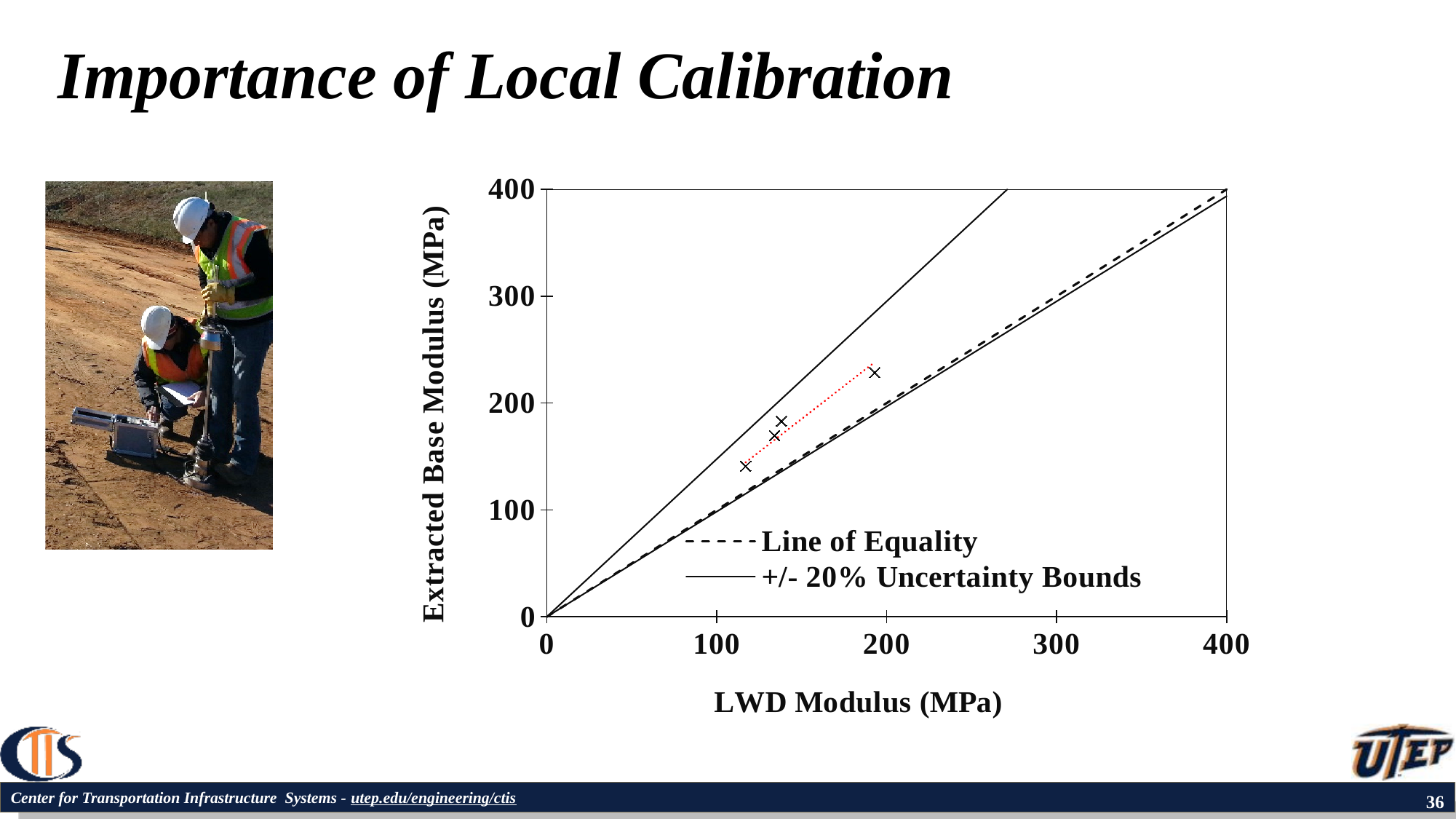
Is the LWD Modulus of the rightmost data point greater or less than 300 MPa? less Do the plotted data points lie above or below the Line of Equality? above What is the label of the y axis? Extracted Base Modulus (MPa) What kind of chart is shown on the slide? scatter chart How many entries does the chart legend list? 2 What is the maximum value shown on the x axis? 400 Do the plotted data points rise or fall as LWD Modulus increases? rise Is the Extracted Base Modulus of the leftmost data point greater or less than 100 MPa? greater What is the label of the x axis? LWD Modulus (MPa) What is the maximum value shown on the y axis? 400 Is the Extracted Base Modulus of the rightmost data point greater or less than 200 MPa? greater How many data points (x markers) are plotted on the chart? 4